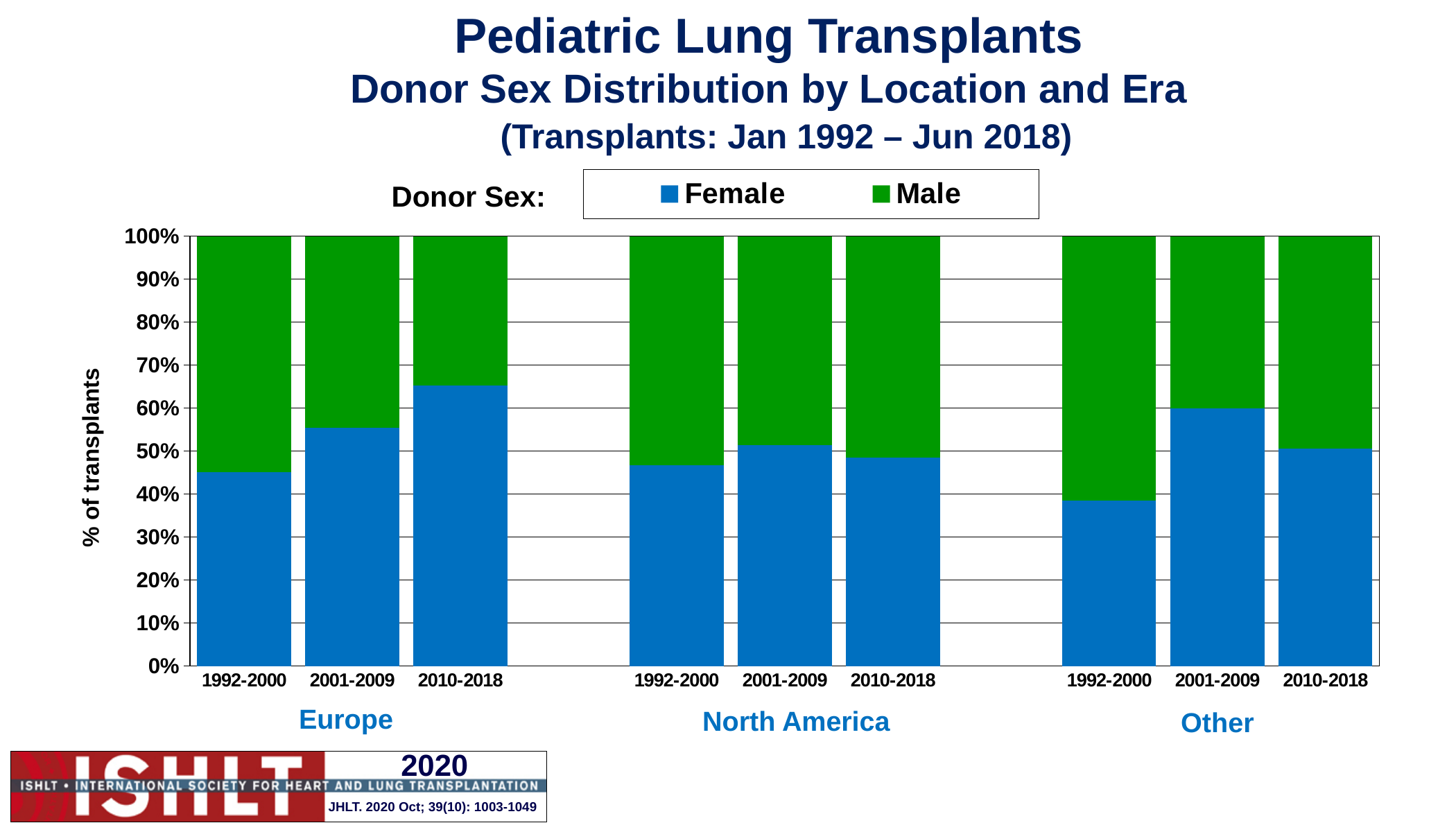
What kind of chart is shown on the slide? Stacked bar chart Is the Female share for Other in 1992-2000 greater or less than 50%? less How many bars are plotted in the chart? 9 Is the Female share for Europe in 2010-2018 greater or less than 60%? greater Is the Female share for Europe in 1992-2000 greater or less than 50%? less Which bar has the lowest Female share? Other 1992-2000 Which has the larger Female share in 2010-2018: Europe or North America? Europe Does the Female share for Europe rise or fall across the eras from 1992-2000 to 2010-2018? rise Which bar has the highest Female share? Europe 2010-2018 What is the label on the y axis? % of transplants How many series does the legend list? 2